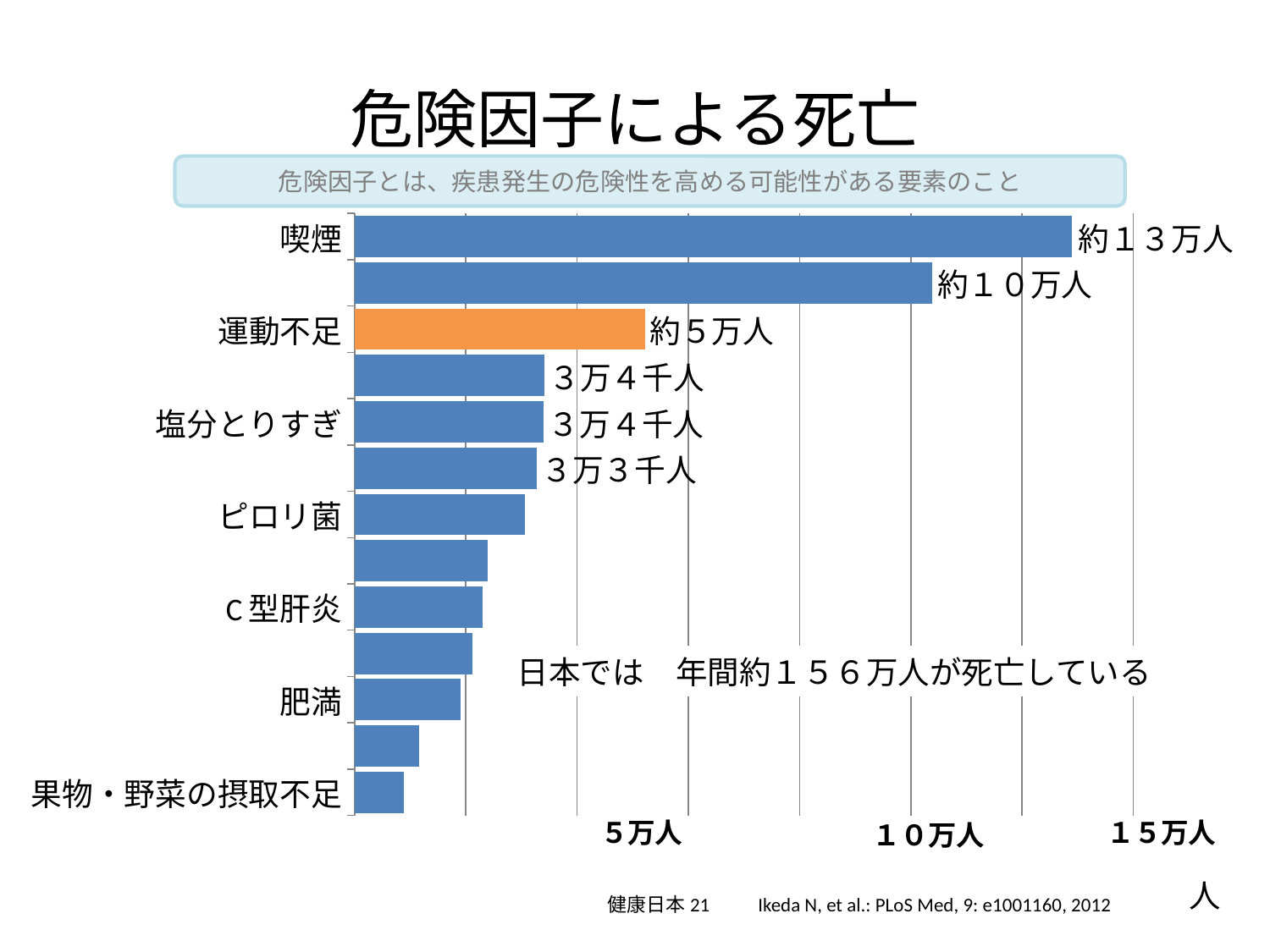
Is the value for 喫煙 greater or less than 10万人? greater Which risk factor has the highest number of deaths? 喫煙 What kind of chart is shown on the slide? bar chart Which labeled risk factor has the lowest number of deaths? 果物・野菜の摂取不足 Which has more deaths, 喫煙 or 運動不足? 喫煙 What is the value shown for 塩分とりすぎ? 3万4千人 What is the value shown for 運動不足? 約5万人 Is the value for ピロリ菌 greater or less than 5万人? less How many bars are plotted in the chart? 13 Which risk factor's bar is highlighted in orange? 運動不足 What is the value shown for 喫煙? 約13万人 Is the value for 肥満 greater or less than 5万人? less